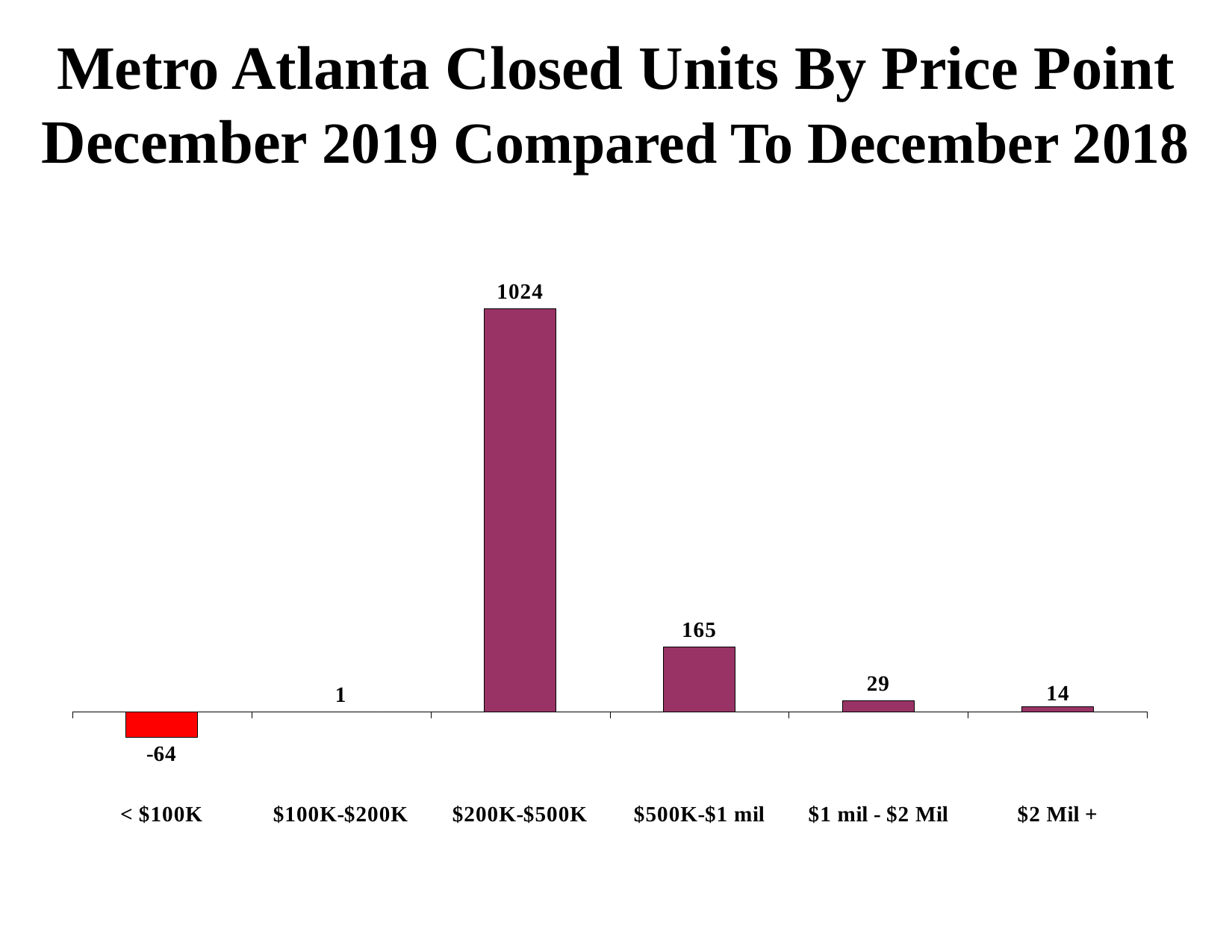
What is the difference between the values for $200K-$500K and $500K-$1 mil? 859 Which is larger, the value for $1 mil - $2 Mil or the value for $2 Mil +? $1 mil - $2 Mil What kind of chart is shown on the slide? Bar chart What is the value for the $200K-$500K price point? 1024 What is the value for the $500K-$1 mil price point? 165 What is the value for the $1 mil - $2 Mil price point? 29 Which price point has the highest value? $200K-$500K Which price point has the lowest value? < $100K What is the value for the < $100K price point? -64 What is the value for the $2 Mil + price point? 14 Which bar is coloured red rather than purple? < $100K How many price point categories are shown on the chart? 6